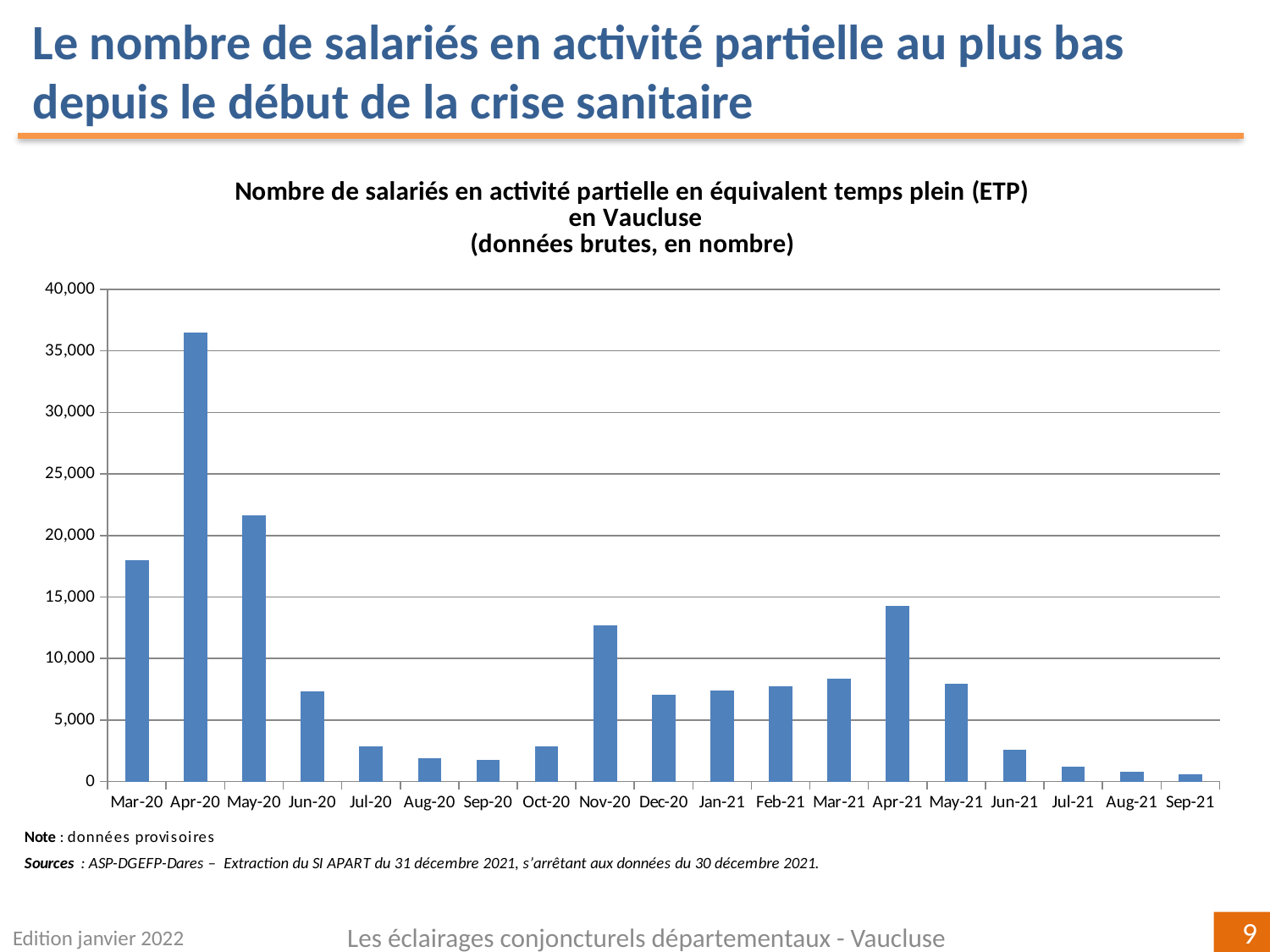
Is the value for Jul-20 greater or less than 5,000? less Which is larger, the value for Mar-20 or the value for May-20? May-20 Which is larger, the value for Nov-20 or the value for Dec-20? Nov-20 Which month has the lowest number of employees in partial activity? Sep-21 Which month has the highest number of employees in partial activity? Apr-20 Is the value for Apr-20 greater or less than 35,000? greater Do the values rise or fall from Apr-21 to Sep-21? fall Is the value for Apr-21 greater or less than 15,000? less How many months are plotted on the x axis? 19 What kind of chart is shown on the slide? bar chart